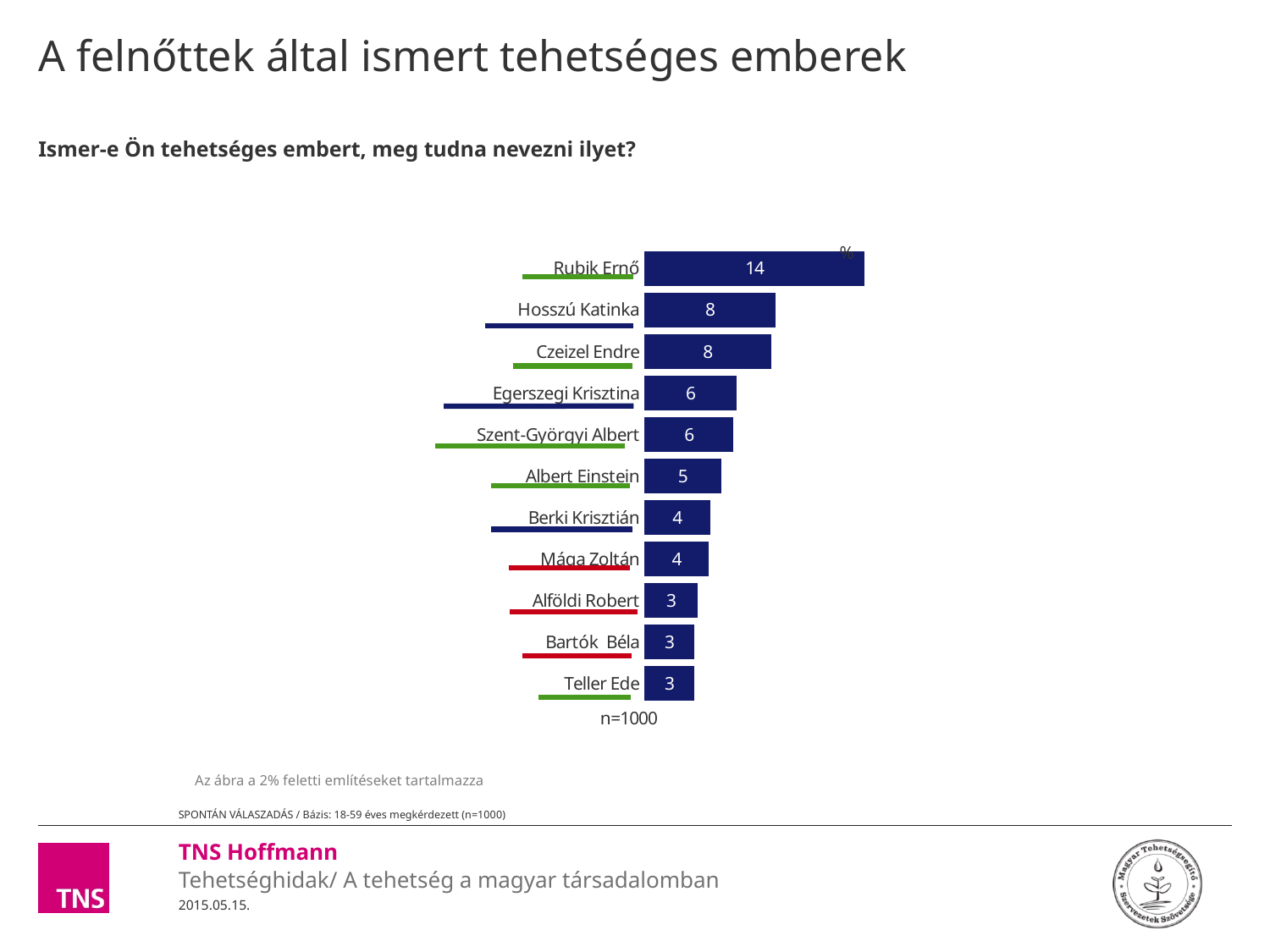
What value is shown for Albert Einstein? 5 What value is shown for Teller Ede? 3 Which is larger, the value for Czeizel Endre or the value for Mága Zoltán? Czeizel Endre What is the difference between the values for Rubik Ernő and Hosszú Katinka? 6 How many people are listed in the chart? 11 What value is shown for Rubik Ernő? 14 What value is shown for Egerszegi Krisztina? 6 Which person has the highest value in the chart? Rubik Ernő What kind of chart is shown on the slide? bar chart What sample size is noted below the chart? n=1000 What value is shown for Berki Krisztián? 4 What is the difference between the values for Szent-Györgyi Albert and Berki Krisztián? 2